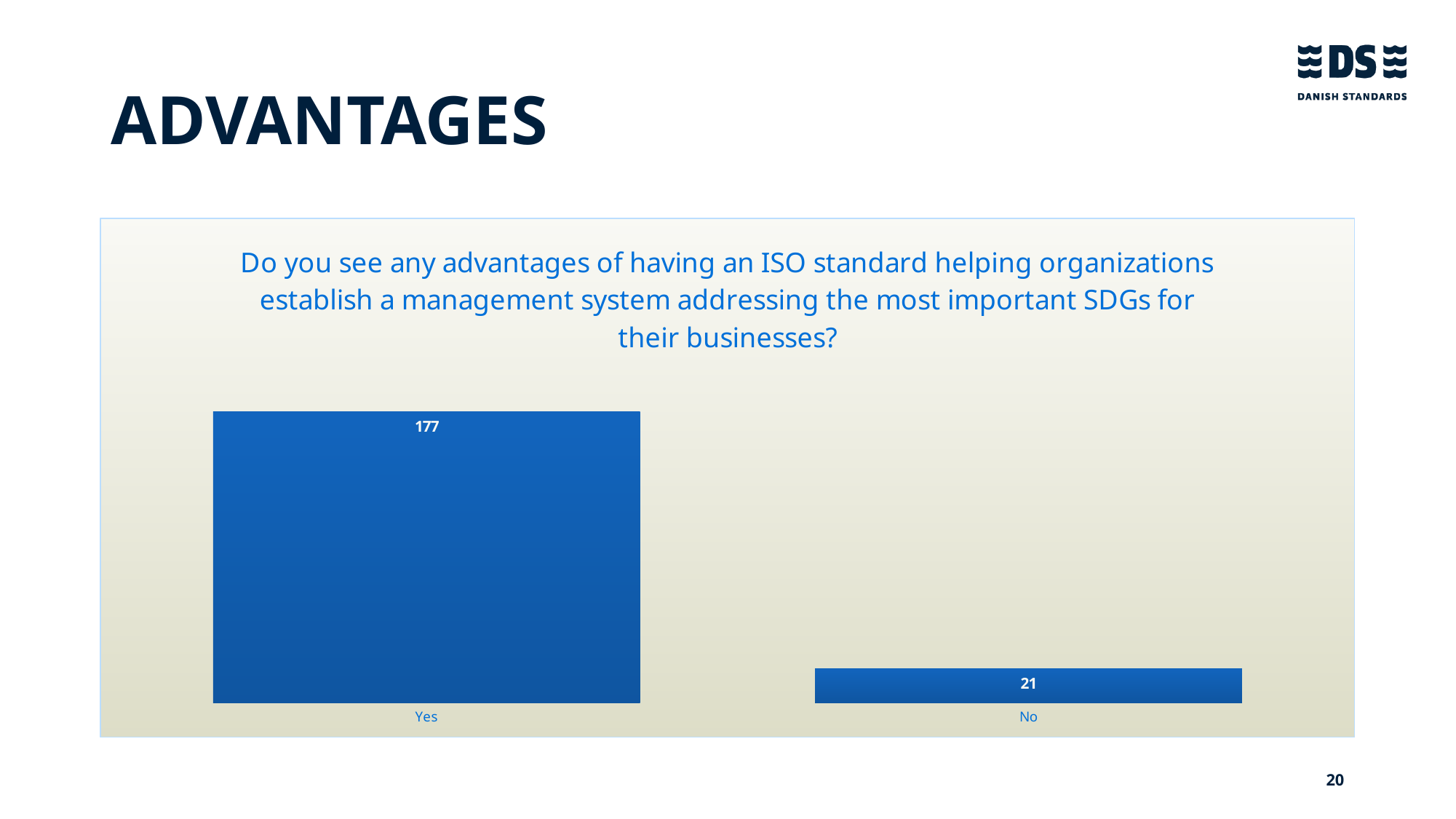
What question does the chart title ask? Do you see any advantages of having an ISO standard helping organizations establish a management system addressing the most important SDGs for their businesses? How many categories are shown in the chart? 2 What is the value for No? 21 What is the difference between the values for Yes and No? 156 Which category has the lowest value? No What kind of chart is shown on the slide? Bar chart What is the value for Yes? 177 Which category has the highest value? Yes What colour are the bars in the chart? Blue Which is larger, the value for Yes or the value for No? Yes What is the total of the values for Yes and No? 198